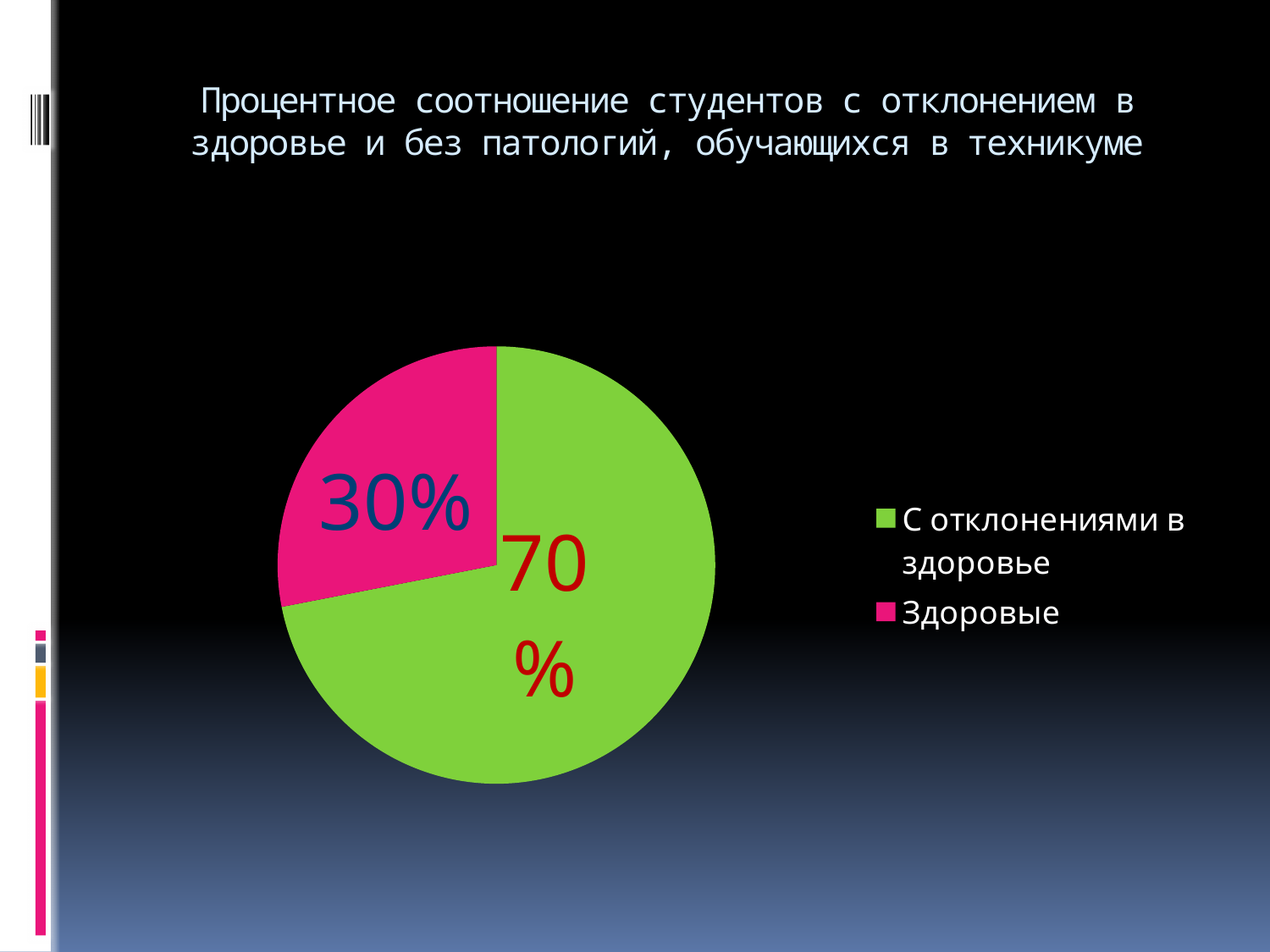
Which is larger: the share for 'Здоровые' or the share for 'С отклонениями в здоровье'? С отклонениями в здоровье What colour is the slice for 'Здоровые'? pink What kind of chart is shown on the slide? pie chart What is the total of the two slices shown in the pie chart? 100% What percentage of students are shown as 'Здоровые'? 30% How many slices does the pie chart have? 2 Which category has the largest share of the pie? С отклонениями в здоровье What is the difference in percentage points between 'С отклонениями в здоровье' and 'Здоровые'? 40 What percentage of students are shown as 'С отклонениями в здоровье'? 70% Which category has the smallest share of the pie? Здоровые What colour is the slice for 'С отклонениями в здоровье'? green How many entries does the legend list? 2